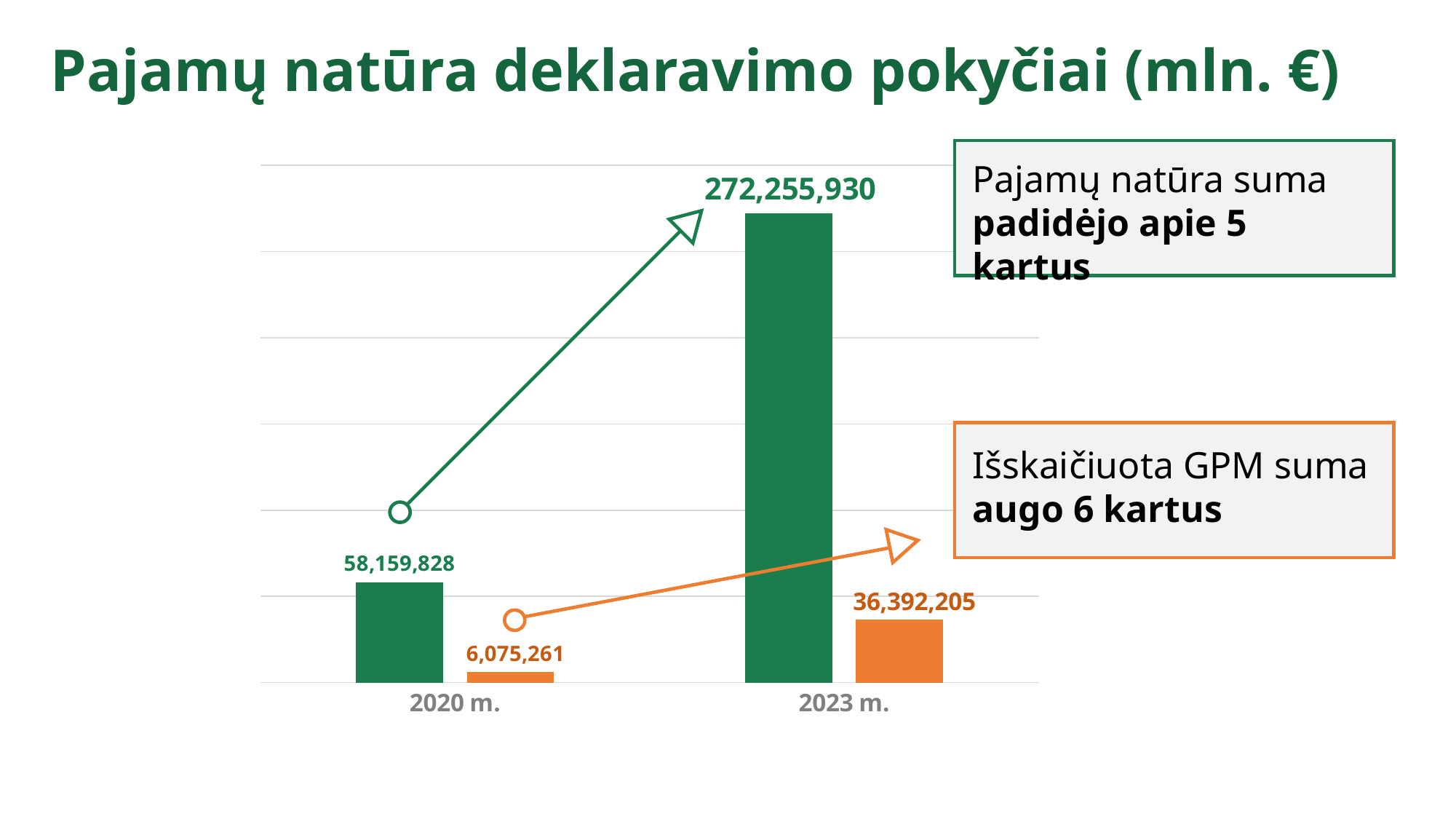
What is the value of the orange bar for 2020 m.? 6,075,261 How many year categories are shown on the x axis? 2 Which bar on the chart has the lowest value? Orange bar for 2020 m. (6,075,261) What kind of chart is shown on the slide? Bar chart What is the difference between the orange bar values for 2023 m. and 2020 m.? 30,316,944 Which is larger: the green bar for 2020 m. or the orange bar for 2023 m.? Green bar for 2020 m. What is the title of the slide containing the chart? Pajamų natūra deklaravimo pokyčiai (mln. €) What is the value of the orange bar for 2023 m.? 36,392,205 What is the value of the green bar for 2020 m.? 58,159,828 Which bar on the chart has the highest value? Green bar for 2023 m. (272,255,930) What is the difference between the green bar values for 2023 m. and 2020 m.? 214,096,102 What is the value of the green bar for 2023 m.? 272,255,930